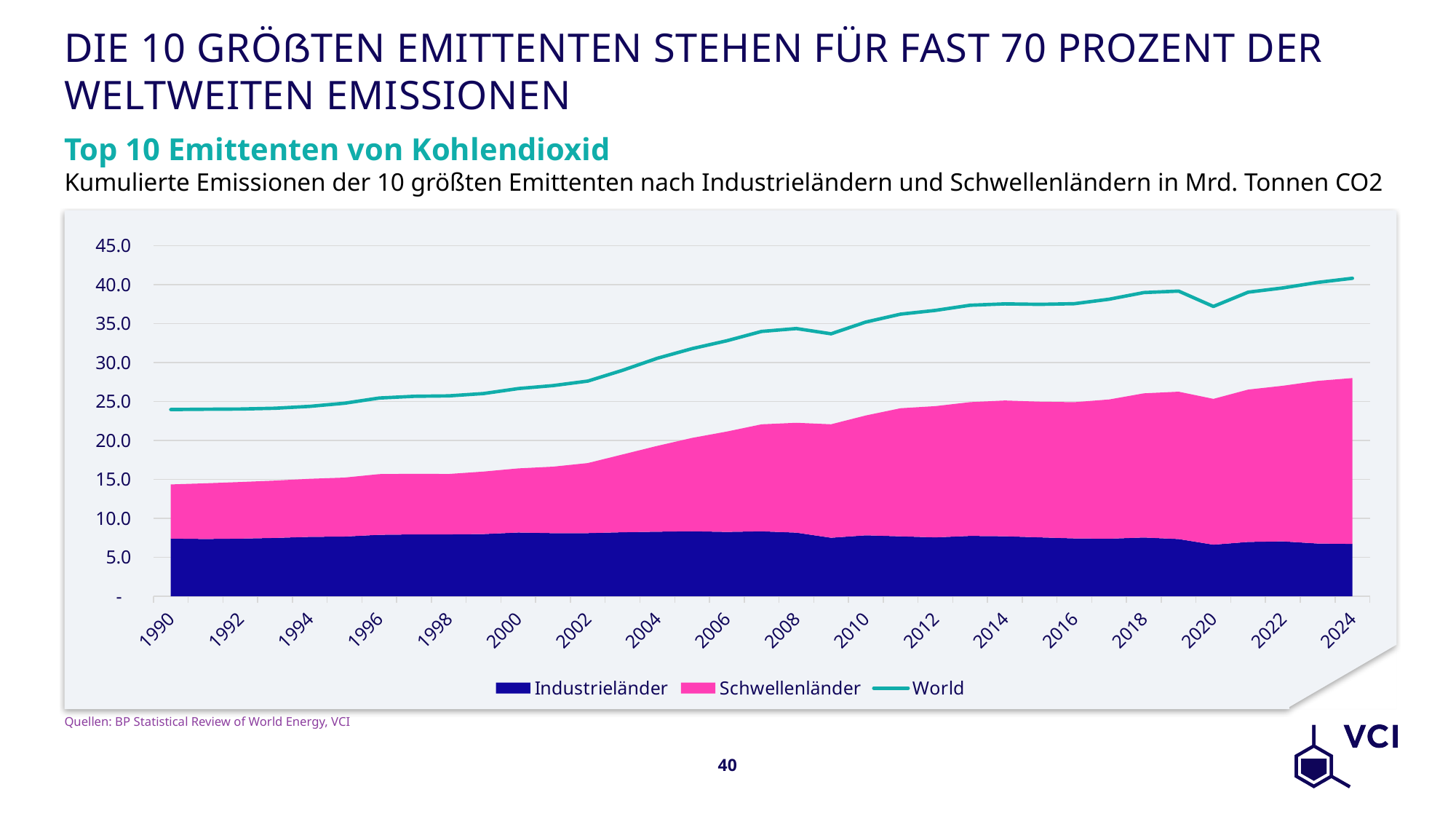
Is the top of the stacked area (Industrieländer plus Schwellenländer) in 2024 greater or less than 25.0? greater Is the value of the World line in 1990 greater or less than 30.0? less What is the title of the chart? Top 10 Emittenten von Kohlendioxid What kind of chart is shown on the slide? combination area and line chart Does the Schwellenländer area grow or shrink from 1990 to 2024? grow Is the Industrieländer area in 2024 greater or less than 10.0? less How many series does the legend list? 3 Does the World line rise or fall overall from 1990 to 2024? rise Which series is shown in dark blue? Industrieländer How many year labels are shown on the x axis? 18